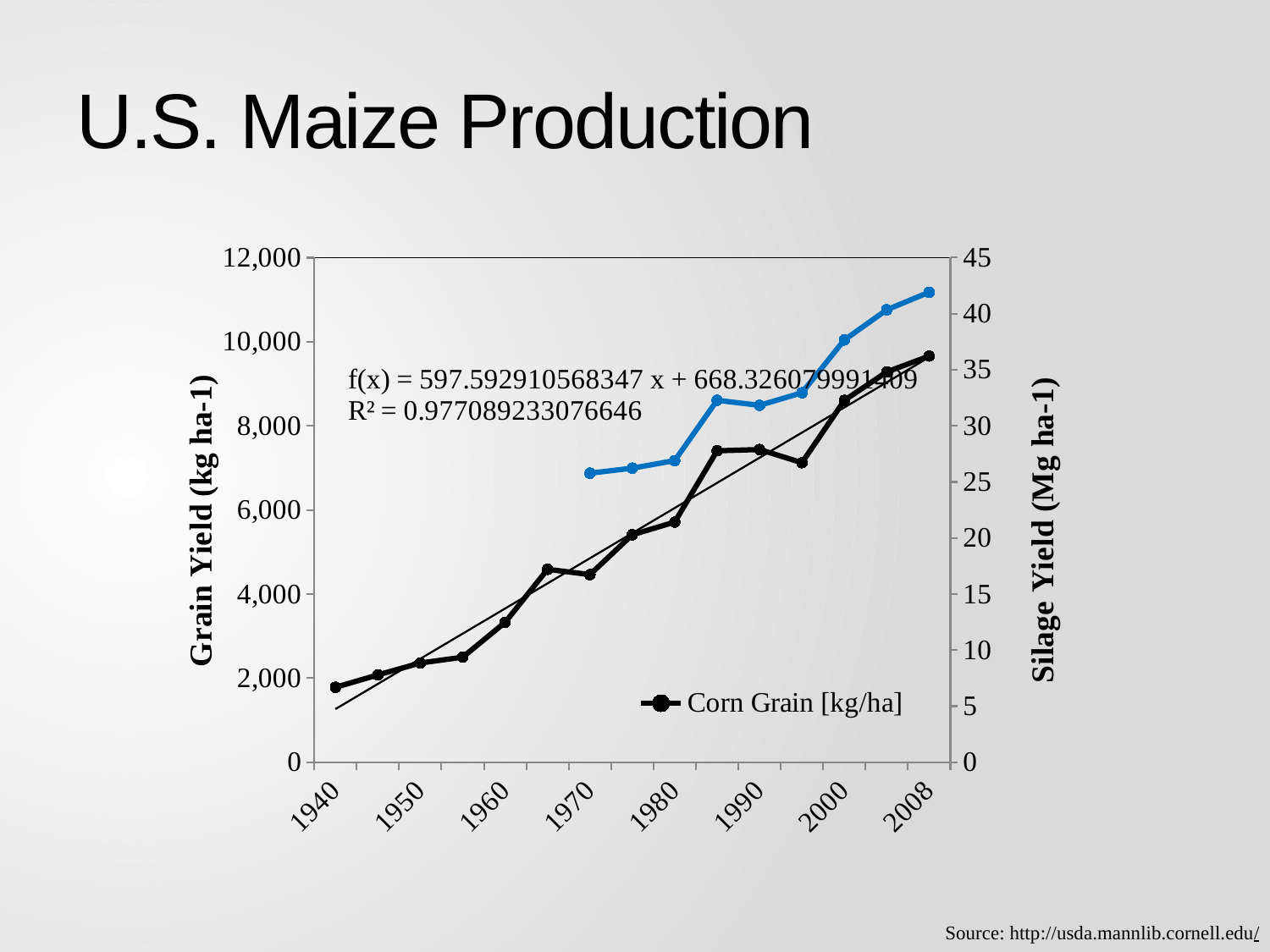
What is the title of the slide's chart? U.S. Maize Production How many series does the chart's legend list? 1 What is the R² value printed on the chart? 0.977089233076646 Which year has the larger Corn Grain [kg/ha] value, 1990 or 2000? 2000 Is the Corn Grain [kg/ha] value for 1970 greater or less than 4,000? greater On the right-hand Silage Yield axis, is the blue series value for 2008 greater or less than 40? greater Does the Corn Grain [kg/ha] series generally rise or fall from 1940 to 2008? rise In which year is the Corn Grain [kg/ha] value lowest? 1940 What kind of chart is shown on the slide? line chart Is the Corn Grain [kg/ha] value for 2008 greater or less than 8,000? greater In which year is the Corn Grain [kg/ha] value highest? 2008